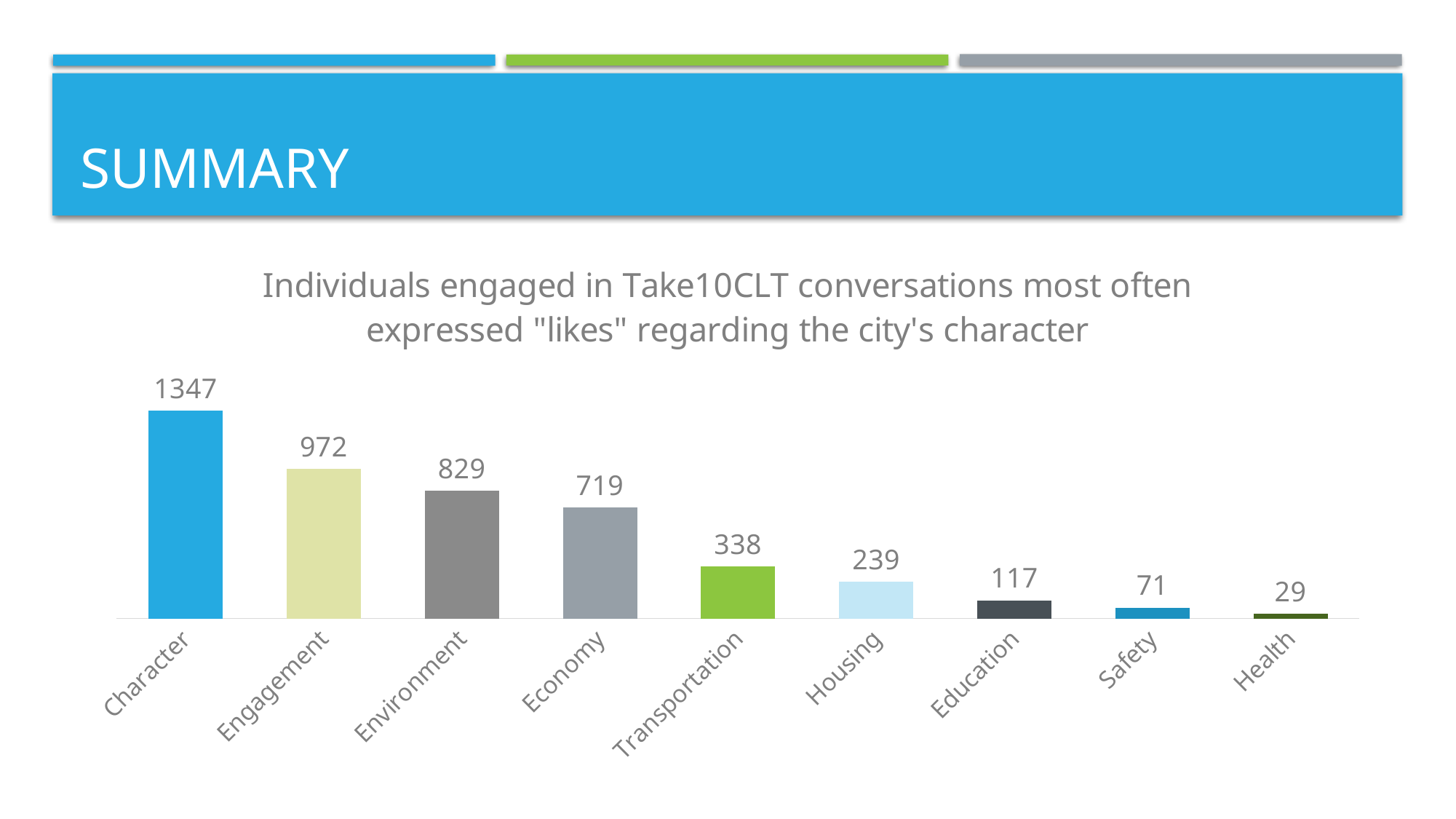
What is the value for Education? 117 Do the values rise or fall from left to right along the x axis? Fall How many categories are shown in the chart? 9 Which category has the lowest value? Health Which category has the highest value? Character What is the difference between the values for Engagement and Environment? 143 What is the value for Transportation? 338 What kind of chart is shown on the slide? Bar chart Which is larger, the value for Economy or the value for Transportation? Economy What is the value for Character? 1347 What is the title of the chart? Individuals engaged in Take10CLT conversations most often expressed "likes" regarding the city's character What is the difference between the values for Housing and Safety? 168